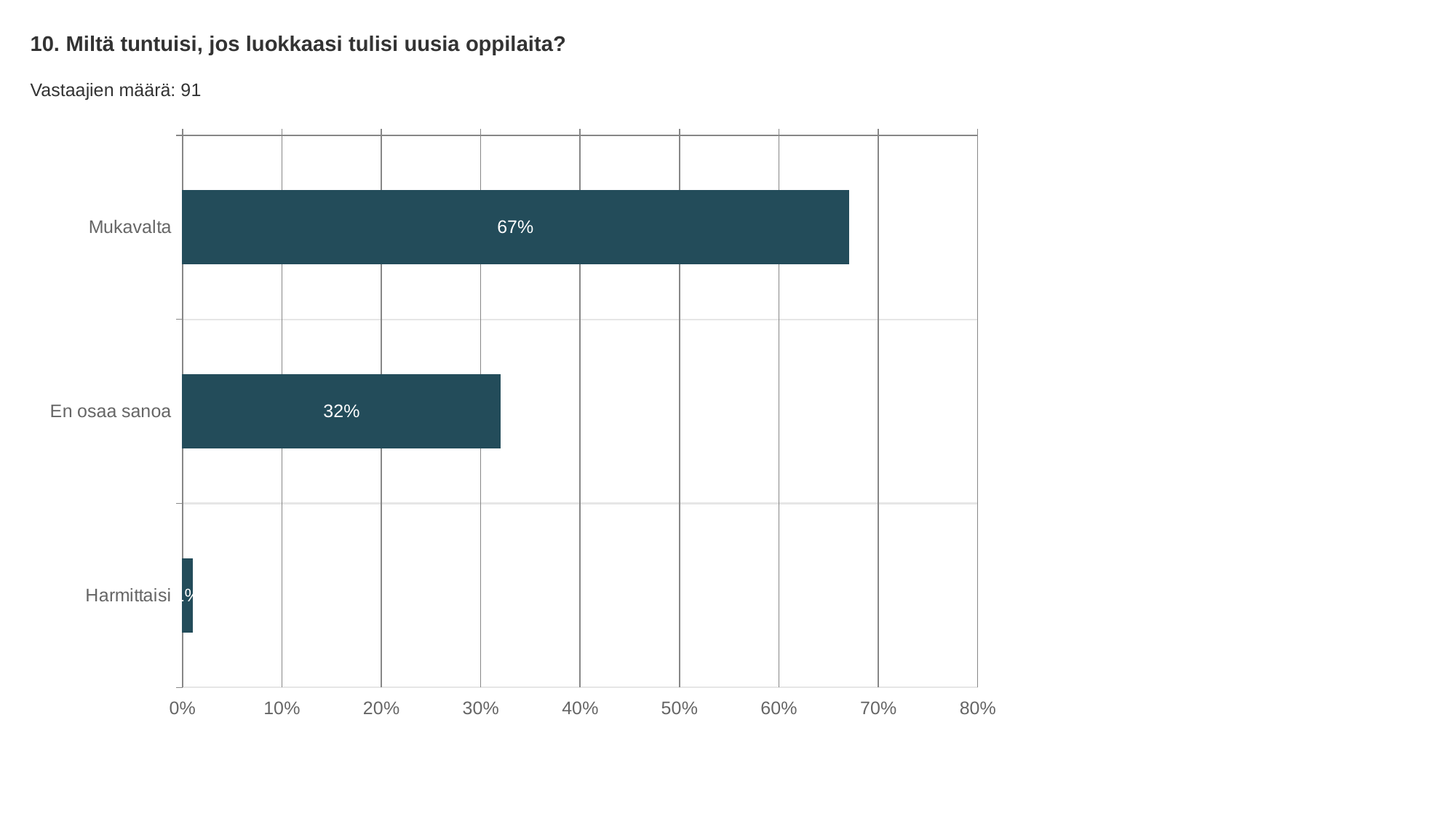
What is the difference between the values for Mukavalta and En osaa sanoa? 35% Which category has the lowest value? Harmittaisi What is the value for En osaa sanoa? 32% Which is larger, the value for En osaa sanoa or the value for Harmittaisi? En osaa sanoa How many categories are shown in the chart? 3 Which category has the highest value? Mukavalta What kind of chart is shown on the slide? bar chart What is the highest value shown on the x axis? 80% What is the number of respondents (Vastaajien määrä) shown on the slide? 91 Is the value for Harmittaisi greater or less than 10%? less What is the value for Mukavalta? 67% Is the value for Mukavalta greater or less than 60%? greater